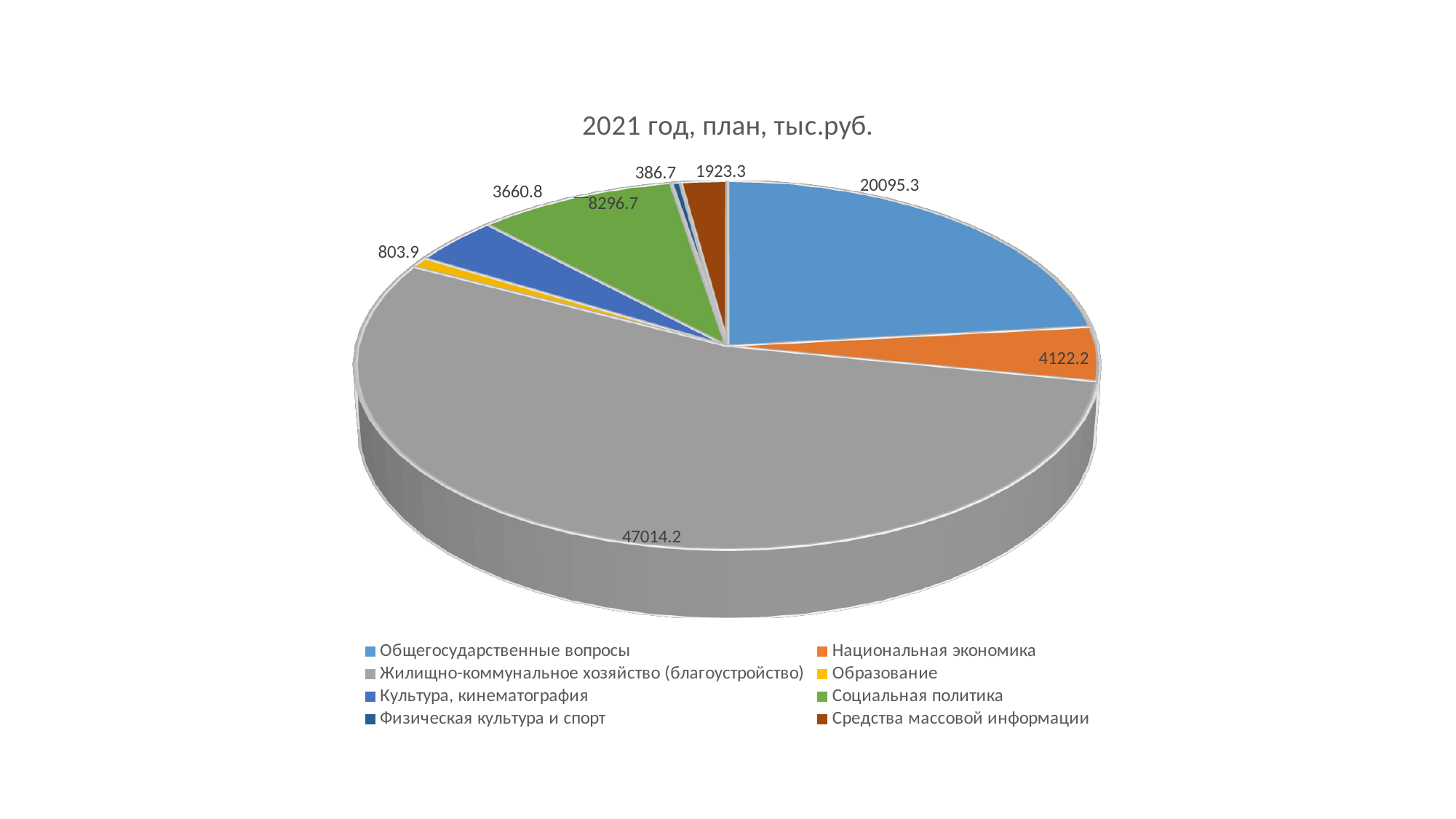
Which category has the smallest slice? Физическая культура и спорт What is the title of the chart? 2021 год, план, тыс.руб. Which is larger, Социальная политика or Культура, кинематография? Социальная политика What is the value for Физическая культура и спорт? 386.7 What is the value for Общегосударственные вопросы? 20095.3 What is the value for Средства массовой информации? 1923.3 What type of chart is shown on the slide? pie chart How many categories does the legend list? 8 What is the value for Социальная политика? 8296.7 Which category has the largest slice? Жилищно-коммунальное хозяйство (благоустройство) What is the difference between the values for Общегосударственные вопросы and Национальная экономика? 15973.1 What is the value for Жилищно-коммунальное хозяйство (благоустройство)? 47014.2